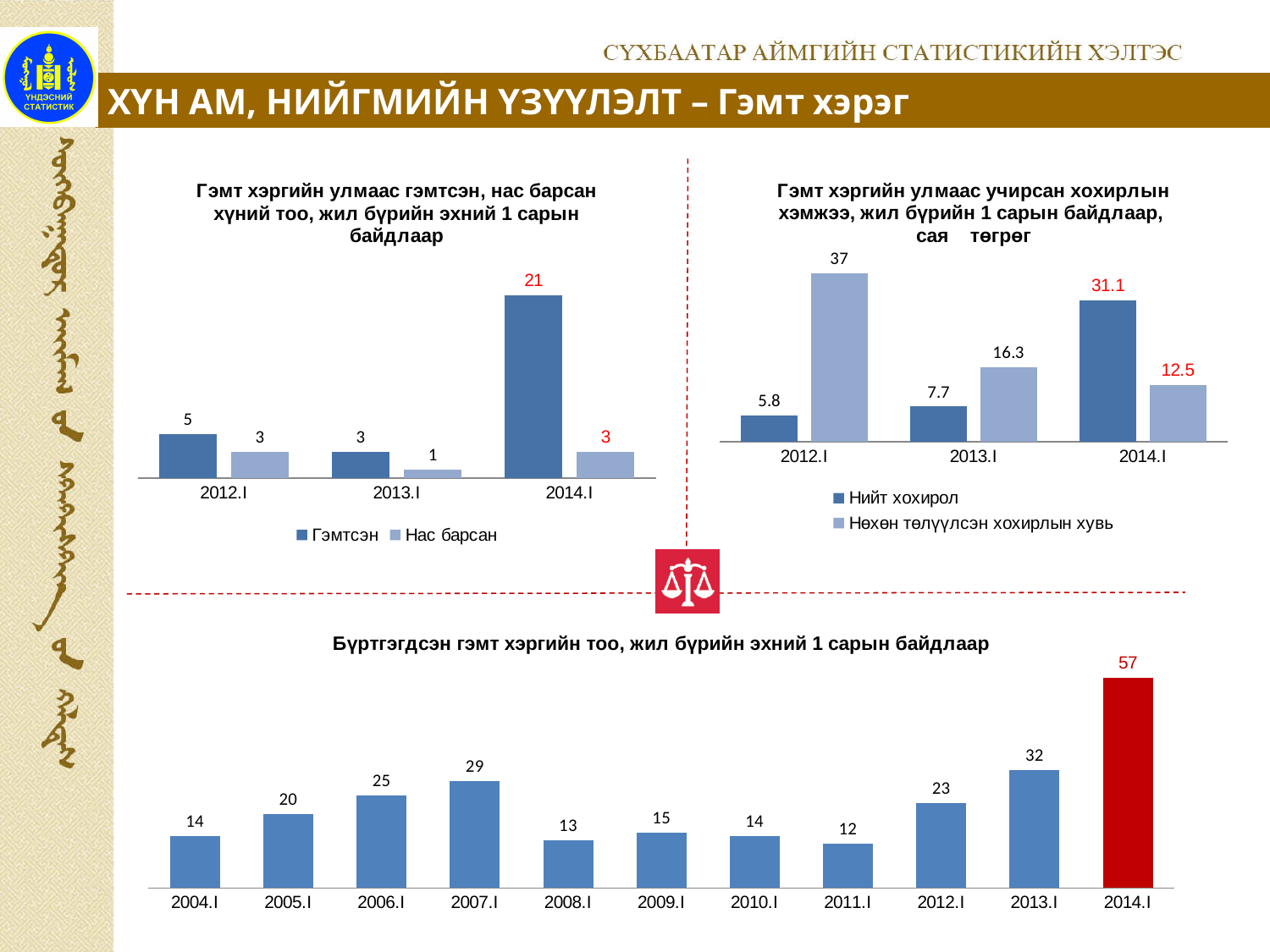
In the top-left chart (Гэмт хэргийн улмаас гэмтсэн, нас барсан хүний тоо), what is the value of Гэмтсэн for 2014.I? 21 In the top-right chart (Гэмт хэргийн улмаас учирсан хохирлын хэмжээ), does the Нөхөн төлүүлсэн хохирлын хувь series rise or fall from 2012.I to 2014.I? fall In the bottom chart (Бүртгэгдсэн гэмт хэргийн тоо), how many categories are shown on the x axis? 11 In the bottom chart (Бүртгэгдсэн гэмт хэргийн тоо), what is the value for 2014.I? 57 In the top-left chart (Гэмт хэргийн улмаас гэмтсэн, нас барсан хүний тоо), how many series does the legend list? 2 In the bottom chart (Бүртгэгдсэн гэмт хэргийн тоо), what is the difference between the values for 2014.I and 2013.I? 25 In the bottom chart (Бүртгэгдсэн гэмт хэргийн тоо), which year has the lowest value? 2011.I In the top-right chart (Гэмт хэргийн улмаас учирсан хохирлын хэмжээ), what is the value of Нийт хохирол for 2014.I? 31.1 In the top-right chart (Гэмт хэргийн улмаас учирсан хохирлын хэмжээ), what is the value of Нөхөн төлүүлсэн хохирлын хувь for 2012.I? 37 What kind of chart is the bottom chart (Бүртгэгдсэн гэмт хэргийн тоо)? bar chart In the top-left chart (Гэмт хэргийн улмаас гэмтсэн, нас барсан хүний тоо), what is the value of Нас барсан for 2013.I? 1 In the bottom chart (Бүртгэгдсэн гэмт хэргийн тоо), which is larger, the value for 2007.I or the value for 2012.I? 2007.I